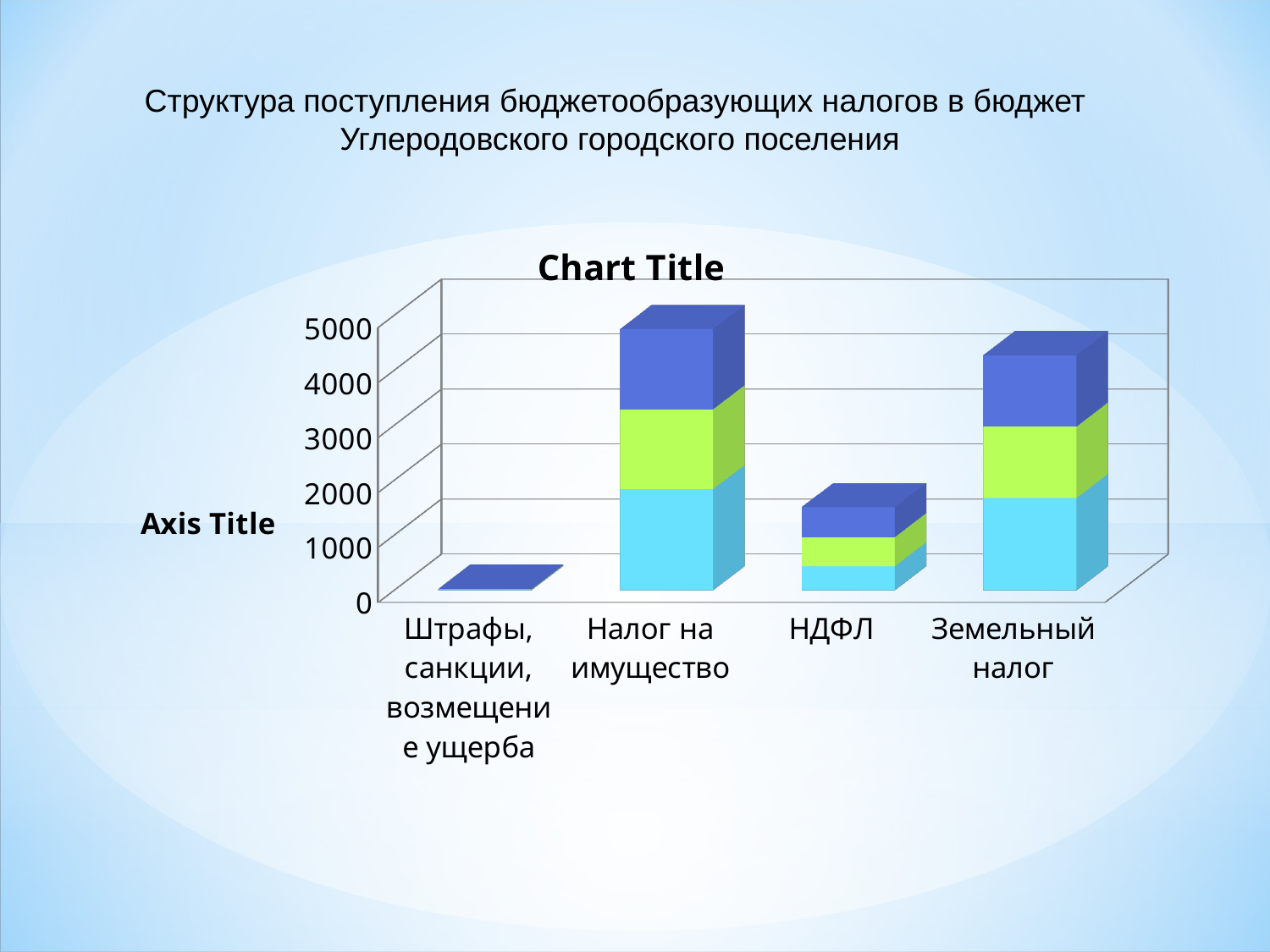
How many categories are shown on the x axis of the chart? 4 Is the total value for Налог на имущество greater or less than 3000? greater Is the total value for Земельный налог greater or less than 3000? greater Which has a larger total bar, Земельный налог or НДФЛ? Земельный налог Which category has the lowest total bar? Штрафы, санкции, возмещение ущерба How many coloured segments make up each stacked bar? 3 What is the title printed above the chart? Chart Title What kind of chart is shown on the slide? Stacked bar chart Which category has the highest total bar? Налог на имущество Which has a larger total bar, Налог на имущество or Земельный налог? Налог на имущество Is the total value for НДФЛ greater or less than 3000? less